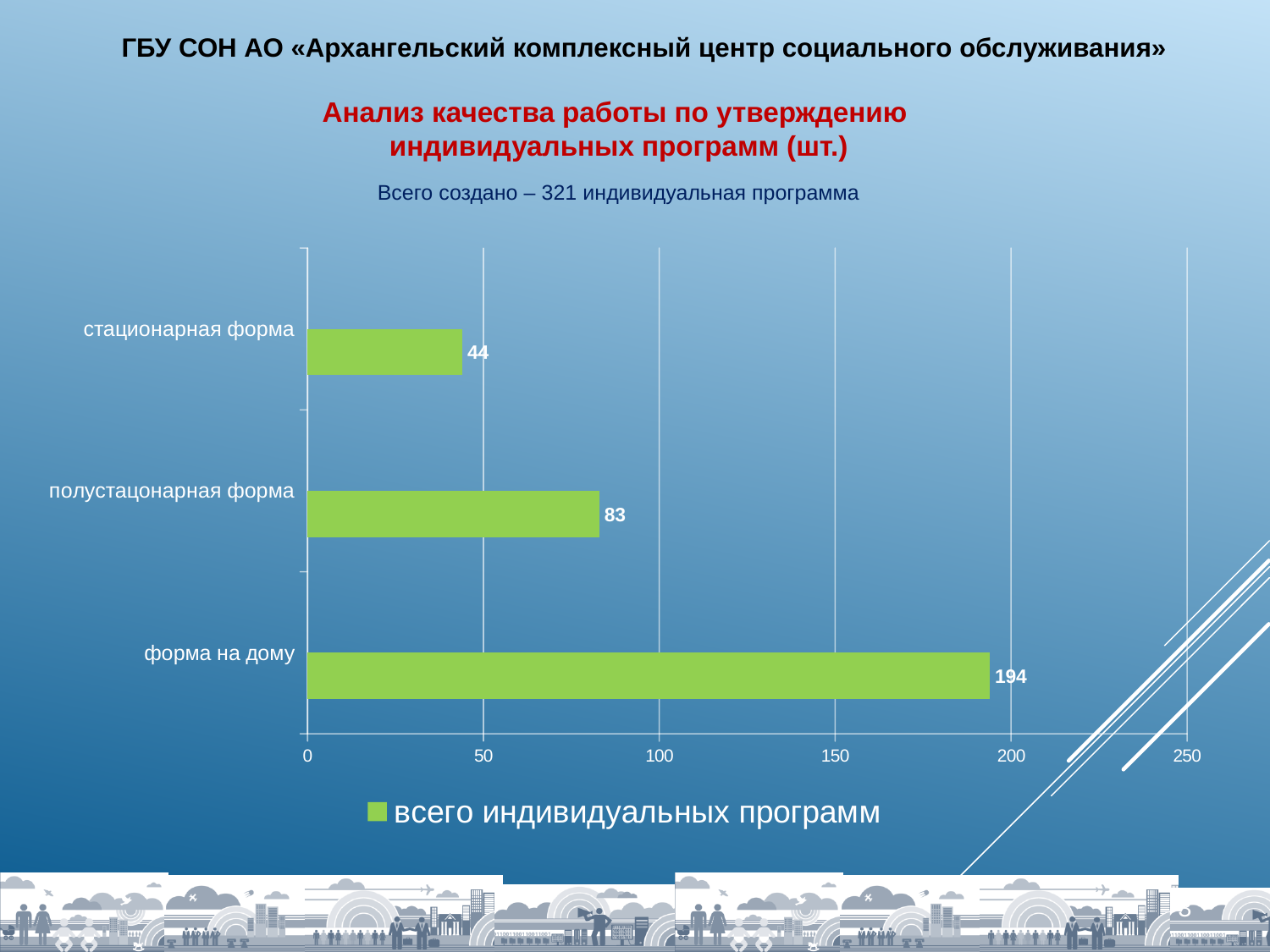
Is the value for «форма на дому» greater or less than 150? greater Which category has the lowest value? стационарная форма What is the difference between the values for «полустацонарная форма» and «стационарная форма»? 39 What is the value for «стационарная форма»? 44 What is the value for «форма на дому»? 194 What is the difference between the values for «форма на дому» and «полустацонарная форма»? 111 What is the value for «полустацонарная форма»? 83 Which is larger: the value for «полустацонарная форма» or «стационарная форма»? полустацонарная форма Which category has the highest value? форма на дому What series name does the legend show? всего индивидуальных программ How many categories are shown in the chart? 3 What kind of chart is shown on the slide? bar chart